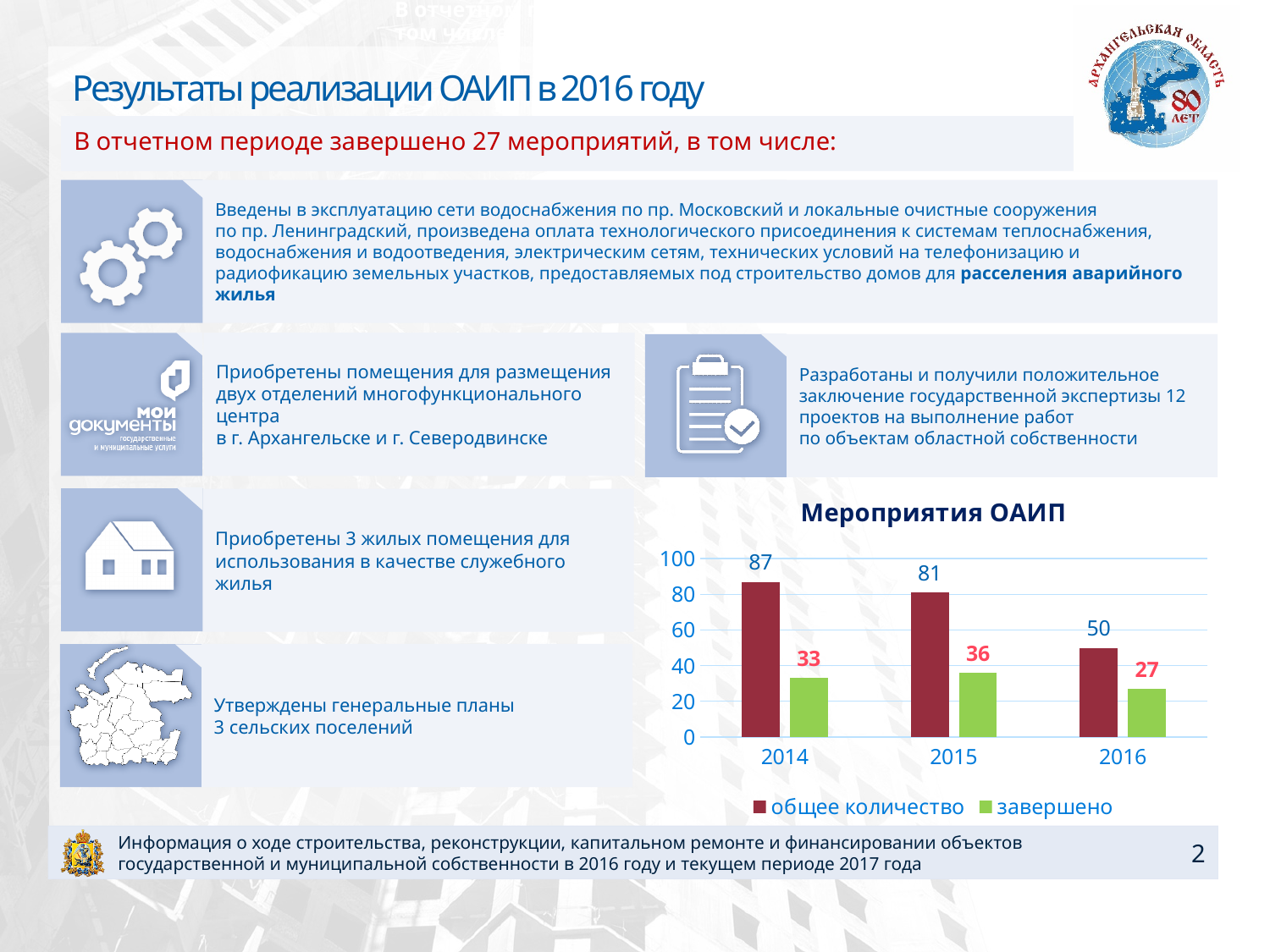
What is the title of the chart? Мероприятия ОАИП What kind of chart is shown on the slide? bar chart What is the value of 'завершено' for 2015? 36 Is the value for 'общее количество' in 2015 greater or less than 60? greater Which is larger: 'завершено' in 2014 or 'завершено' in 2015? 2015 How many years are shown on the x axis of the chart? 3 What is the difference between 'общее количество' and 'завершено' in 2015? 45 What is the value of 'общее количество' for 2014? 87 What is the value of 'общее количество' for 2016? 50 How many series does the chart legend list? 2 Which year has the lowest value for 'завершено'? 2016 Which year has the highest value for 'общее количество'? 2014